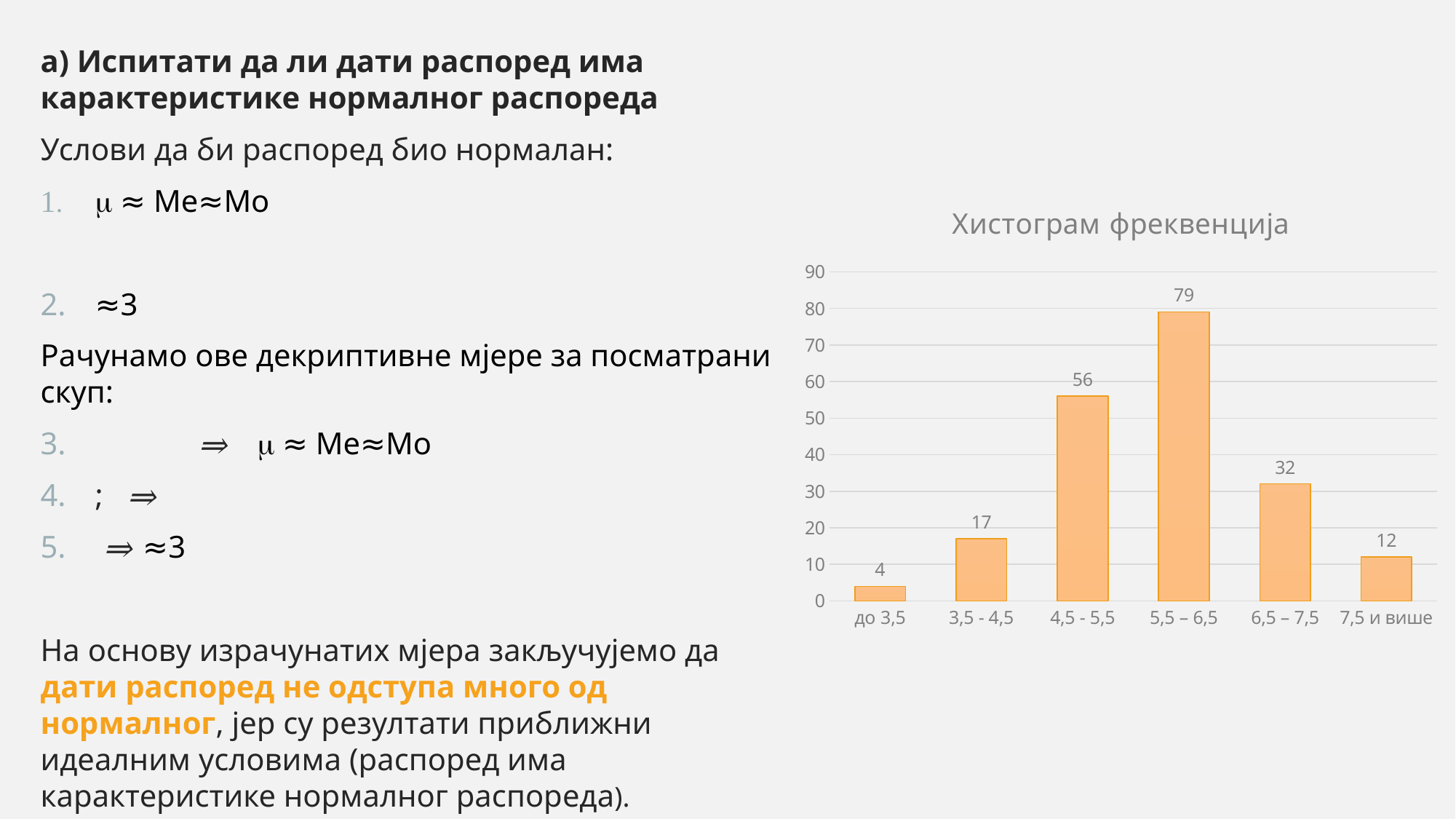
What is the value for the category "5,5 – 6,5"? 79 Which category has the lowest value? до 3,5 What is the value for the category "7,5 и више"? 12 How many categories are shown on the x axis? 6 What kind of chart is shown on the slide? bar chart What is the title of the chart? Хистограм фреквенција What is the value for the category "до 3,5"? 4 Which category has the highest value? 5,5 – 6,5 Which is larger, the value for "3,5 - 4,5" or the value for "6,5 – 7,5"? 6,5 – 7,5 What is the total of the values for "до 3,5" and "3,5 - 4,5"? 21 Is the value for "4,5 - 5,5" greater or less than 50? greater What is the difference between the values for "5,5 – 6,5" and "4,5 - 5,5"? 23